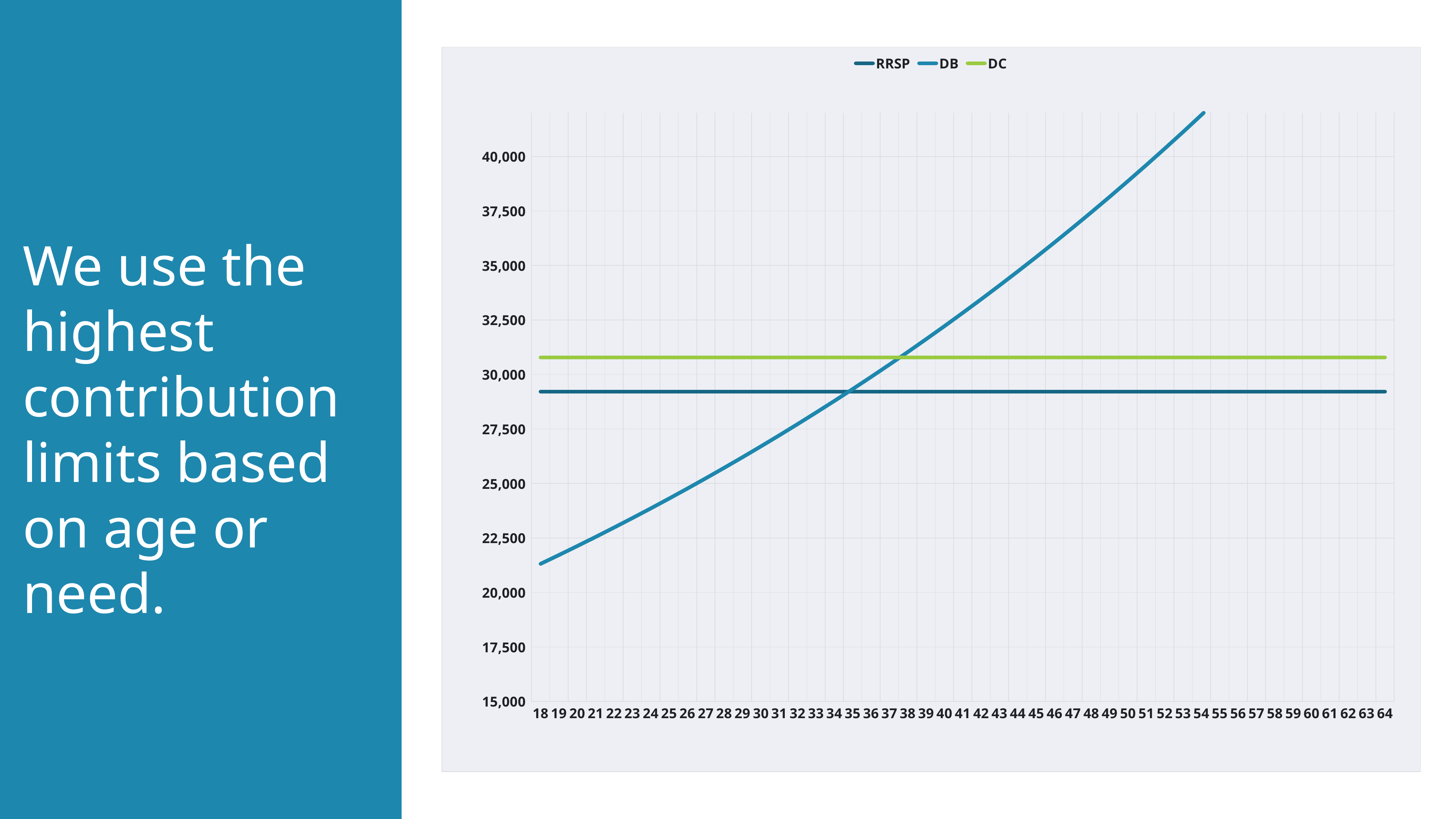
How many age values are shown along the x axis? 47 Does the DB line rise or fall as age increases along the x axis? rises Is the value of the DB line at age 54 greater or less than 40,000? greater Which series is drawn in green? DC Is the value of the RRSP line greater or less than 30,000? less Is the value of the DC line greater or less than 30,000? greater At age 30, which series has the highest value? DC What kind of chart is shown on the slide? line chart How many series does the legend list? 3 Which is higher, the DC line or the RRSP line? DC What are the three series named in the legend? RRSP, DB, DC